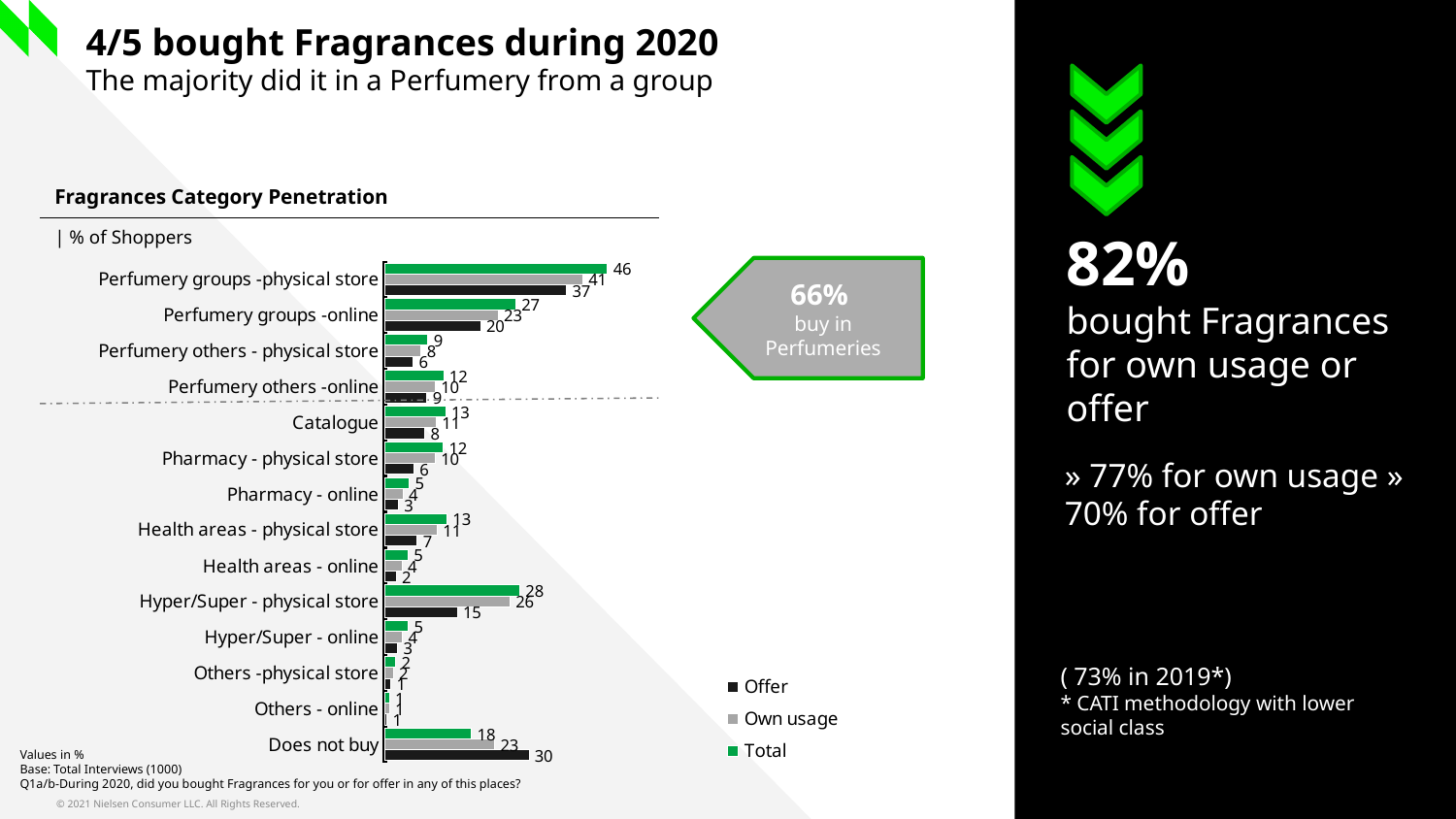
In the Fragrances Category Penetration chart, which has a larger Total value: Hyper/Super - physical store or Perfumery groups - online? Hyper/Super - physical store In the Fragrances Category Penetration chart, what is the Total value for Perfumery groups - physical store? 46 In the Fragrances Category Penetration chart, which category has the highest Total value? Perfumery groups - physical store In the Fragrances Category Penetration chart, what is the Offer value for Does not buy? 30 In the Fragrances Category Penetration chart, what is the difference between the Total and Offer values for Perfumery groups - physical store? 9 How many series does the legend of the Fragrances Category Penetration chart list? 3 In the Fragrances Category Penetration chart, what is the Offer value for Hyper/Super - physical store? 15 In the Fragrances Category Penetration chart, what is the Total value for Catalogue? 13 What type of chart is the Fragrances Category Penetration chart? Bar chart In the Fragrances Category Penetration chart, how much higher is the Offer value than the Total value for Does not buy? 12 In the Fragrances Category Penetration chart, what is the Own usage value for Hyper/Super - physical store? 26 How many categories are shown in the Fragrances Category Penetration chart? 14